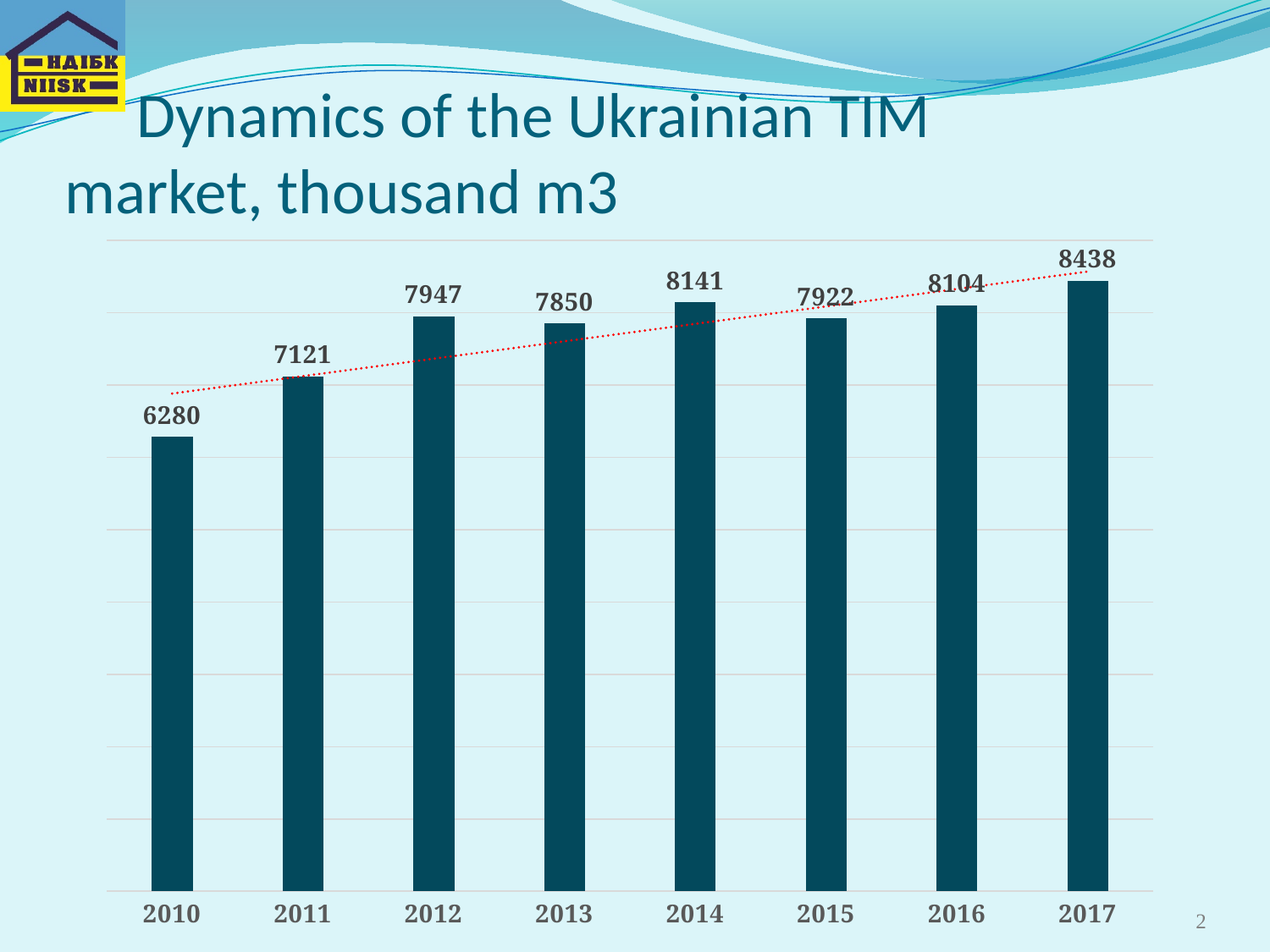
What is the value for 2017? 8438 What is the difference between the values for 2017 and 2010? 2158 Which is larger, the value for 2014 or the value for 2015? 2014 What is the title of the slide? Dynamics of the Ukrainian TIM market, thousand m3 Which year has the highest value? 2017 What kind of chart is shown on the slide? bar chart What is the difference between the values for 2012 and 2011? 826 Which year has the lowest value? 2010 What is the value for 2010? 6280 How many years are shown on the x axis? 8 What is the value for 2014? 8141 What is the value for 2013? 7850